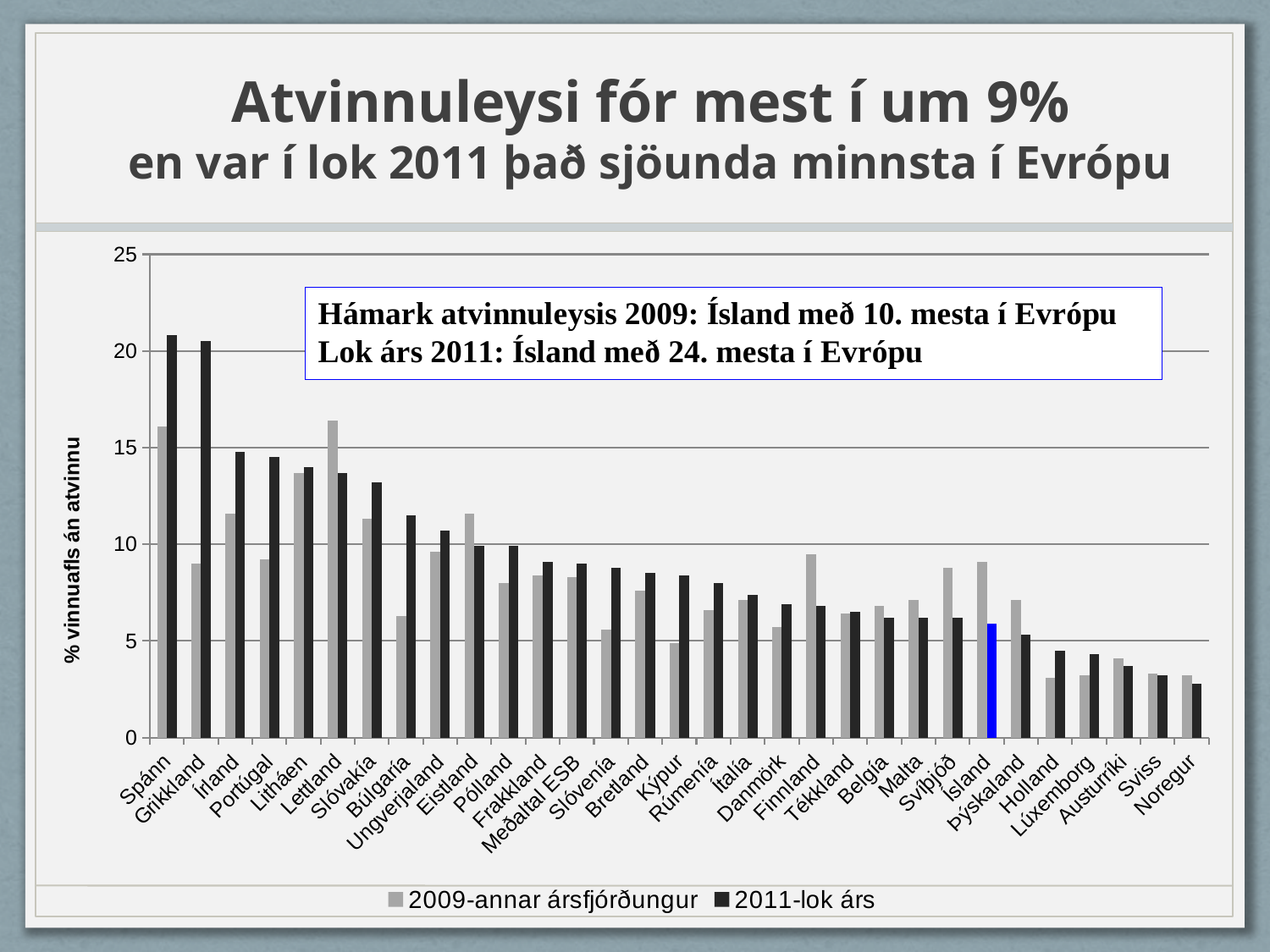
Do the 2011-lok árs values generally rise or fall moving from left to right along the x axis? fall What kind of chart is shown on the slide? bar chart For Grikkland, which series has the larger value: 2009-annar ársfjórðungur or 2011-lok árs? 2011-lok árs Is the 2011-lok árs value for Ísland greater or less than 5? greater How many countries/categories are shown on the x axis? 31 Which country's 2011-lok árs bar is highlighted in blue? Ísland For Ísland, which series has the larger value: 2009-annar ársfjórðungur or 2011-lok árs? 2009-annar ársfjórðungur Is the 2009-annar ársfjórðungur value for Lettland greater or less than 15? greater Is the 2011-lok árs value for Noregur greater or less than 5? less How many series does the legend list? 2